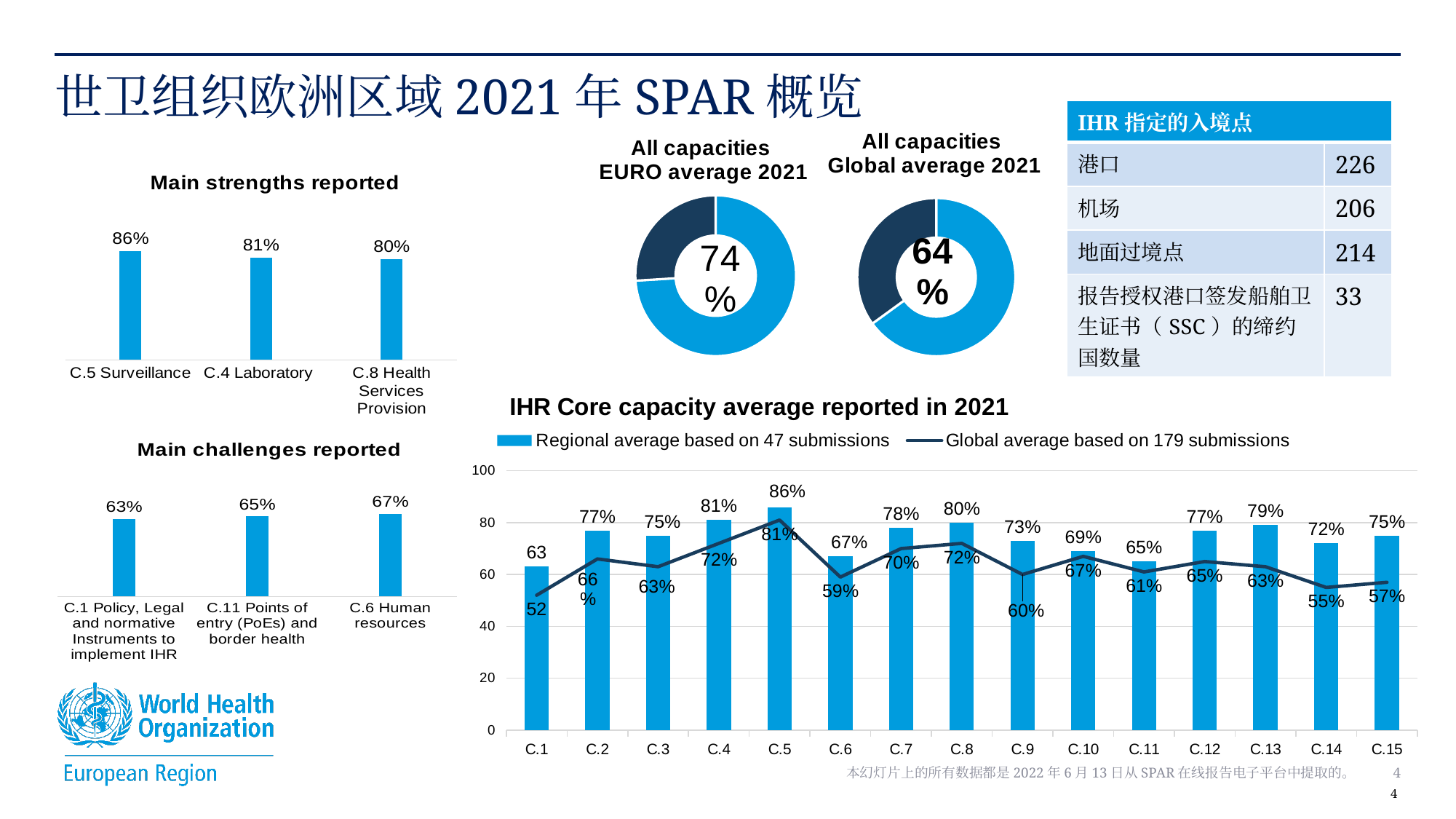
In the 'IHR Core capacity average reported in 2021' chart, what is the regional average for C.5? 86% How many series does the legend of the 'IHR Core capacity average reported in 2021' chart list? 2 In the 'All capacities EURO average 2021' donut chart, what value is shown in the centre? 74% In the 'IHR Core capacity average reported in 2021' chart, what is the global average for C.14? 55% In the 'Main strengths reported' chart, which category has the highest value? C.5 Surveillance How many core capacities are shown on the x axis of the 'IHR Core capacity average reported in 2021' chart? 15 What kind of chart is 'Main challenges reported'? Bar chart In the 'Main challenges reported' chart, which category has the lowest value? C.1 Policy, Legal and normative Instruments to implement IHR In the 'Main strengths reported' chart, what is the value for C.4 Laboratory? 81% In the 'IHR Core capacity average reported in 2021' chart, what is the difference between the regional average and the global average for C.9? 13 percentage points In the 'All capacities Global average 2021' donut chart, what value is shown in the centre? 64% Which is larger, the 'All capacities EURO average 2021' or the 'All capacities Global average 2021'? EURO average 2021